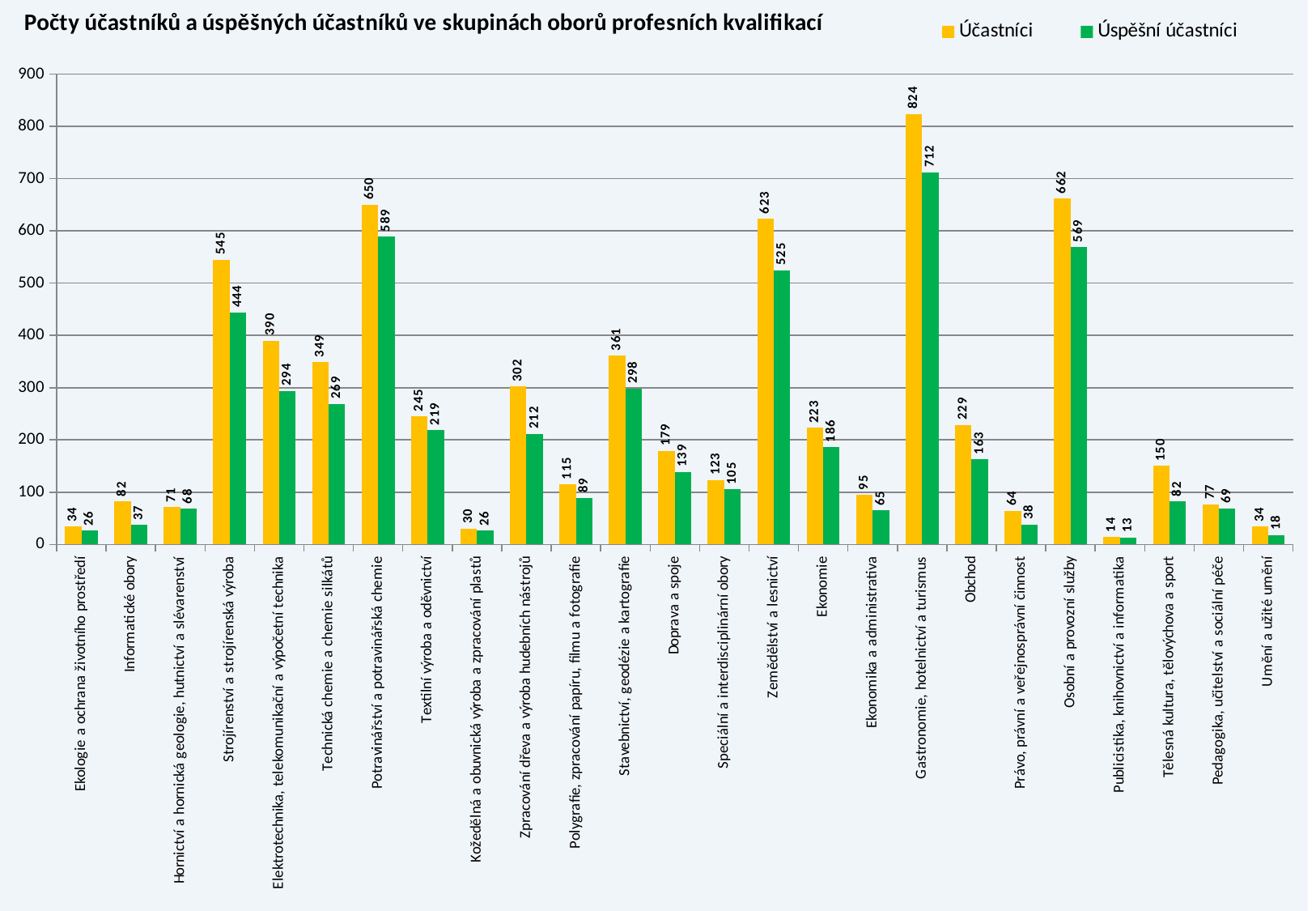
Which category has the lowest value of Úspěšní účastníci? Publicistika, knihovnictví a informatika Which is larger: Úspěšní účastníci for Obchod or Úspěšní účastníci for Ekonomie? Ekonomie What is the value of Účastníci for Gastronomie, hotelnictví a turismus? 824 What is the value of Účastníci for Doprava a spoje? 179 What is the difference between Účastníci and Úspěšní účastníci for Strojírenství a strojírenská výroba? 101 What is the value of Úspěšní účastníci for Potravinářství a potravinářská chemie? 589 Which colour represents the Úspěšní účastníci series? green What kind of chart is shown on the slide? bar chart What is the difference between Účastníci for Zemědělství a lesnictví and Účastníci for Osobní a provozní služby? 39 How many categories are shown on the x axis? 25 Which category has the highest value of Účastníci? Gastronomie, hotelnictví a turismus How many series does the legend list? 2